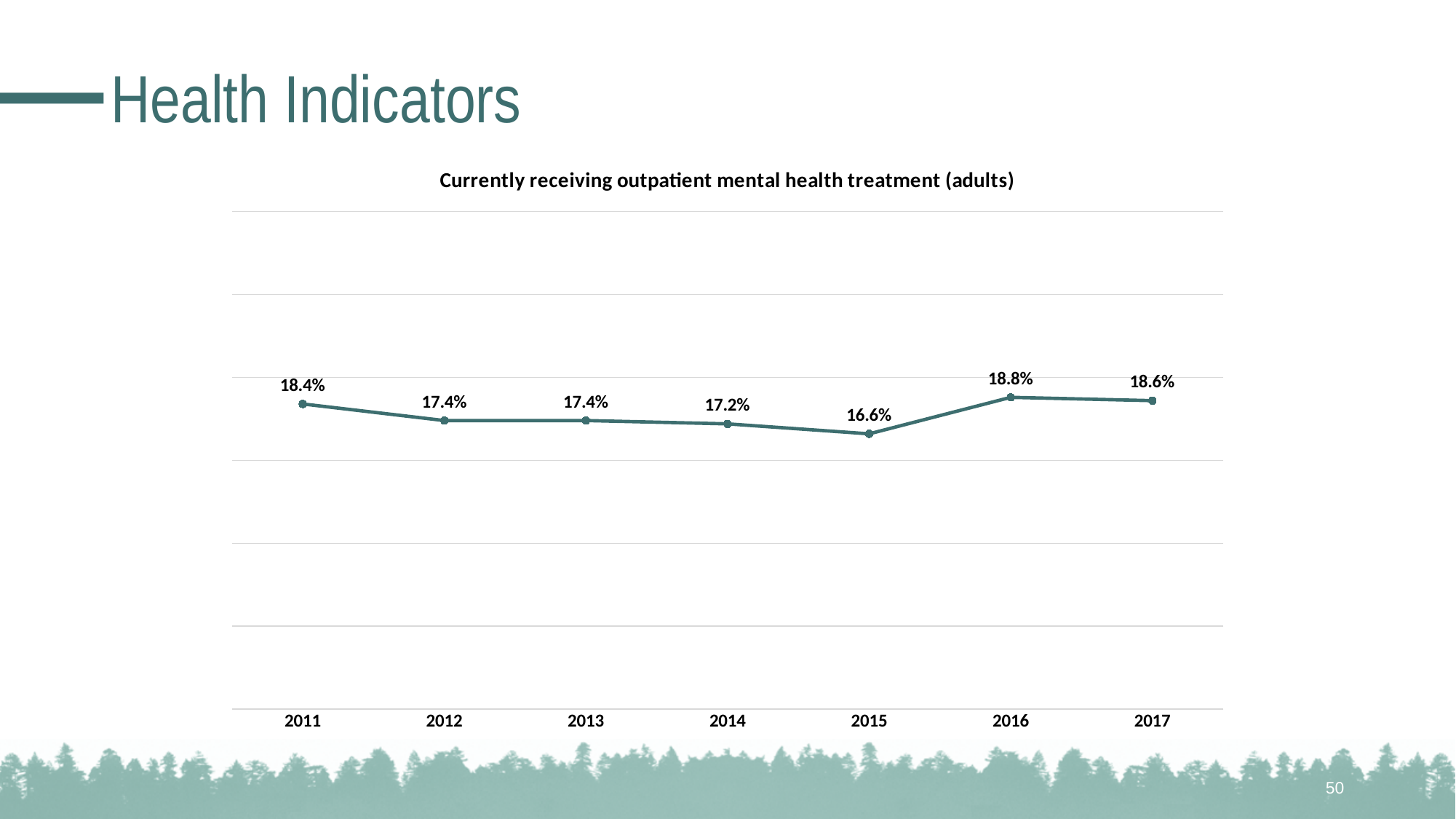
What kind of chart is shown? Line chart What is the value for 2017? 18.6% How many years are plotted on the chart? 7 What is the value for 2015? 16.6% What is the value for 2011? 18.4% Do the values rise or fall from 2011 to 2015? Fall Which year has the lowest value? 2015 What is the difference between the values for 2016 and 2015? 2.2% Which is larger, the value for 2012 or the value for 2016? 2016 What is the title of the chart? Currently receiving outpatient mental health treatment (adults) What is the difference between the values for 2011 and 2014? 1.2% Which year has the highest value? 2016